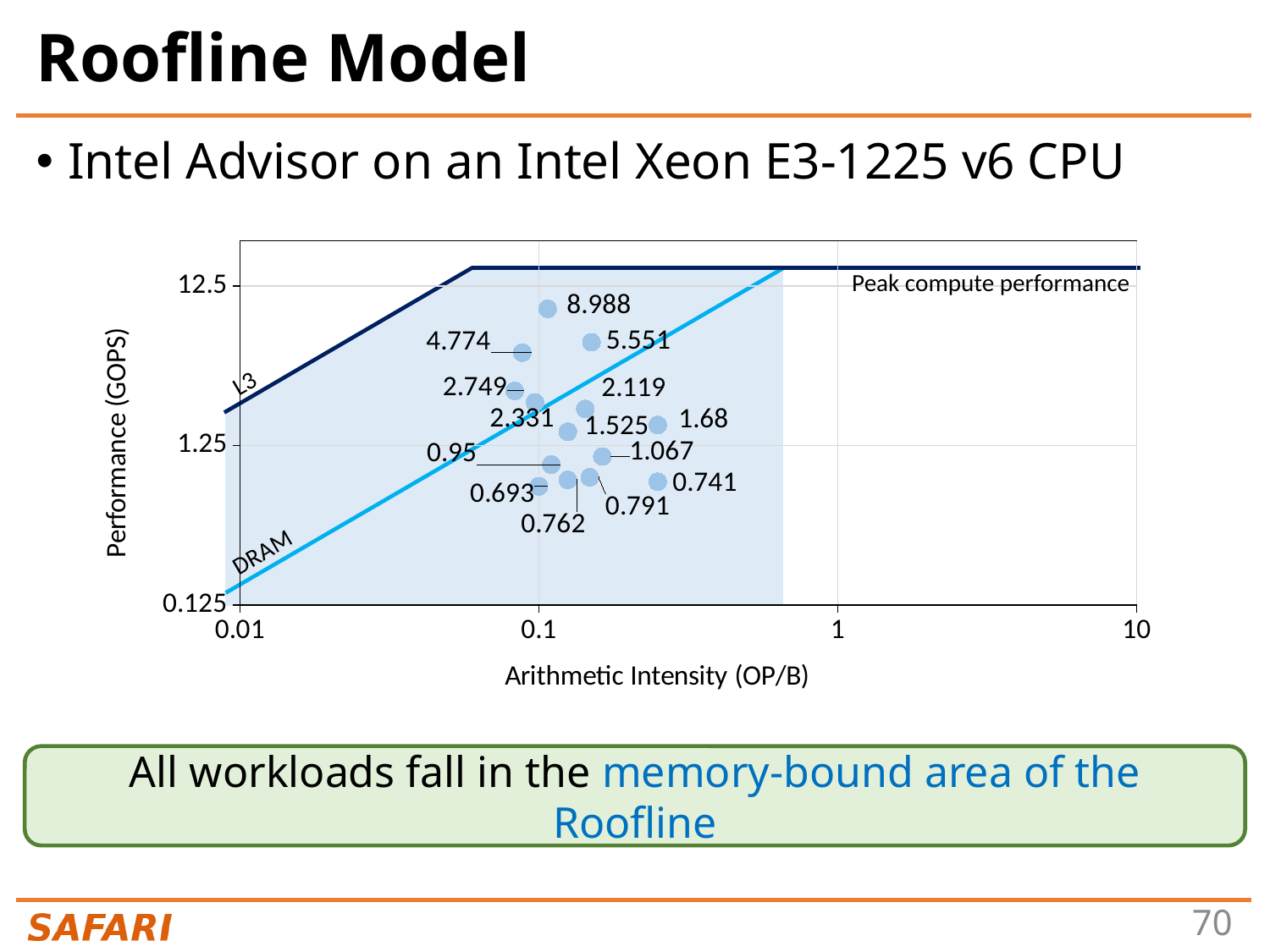
What label is given to the horizontal line at the top of the chart? Peak compute performance What is the difference between the labeled points 1.067 and 0.741? 0.326 What is the highest labeled performance value among the plotted workload points? 8.988 What kind of chart is shown on the slide? scatter chart What is the largest value shown on the x axis? 10 Which labeled point has the larger value, 2.331 or 2.749? 2.749 What is the title of the x axis? Arithmetic Intensity (OP/B) What is the difference between the two highest labeled points, 8.988 and 5.551? 3.437 What is the lowest labeled performance value among the plotted workload points? 0.693 Is the peak compute performance line greater or less than 12.5 GOPS? greater How many data labels are shown on the plotted workload points? 14 Which labeled point has the larger value, 4.774 or 5.551? 5.551